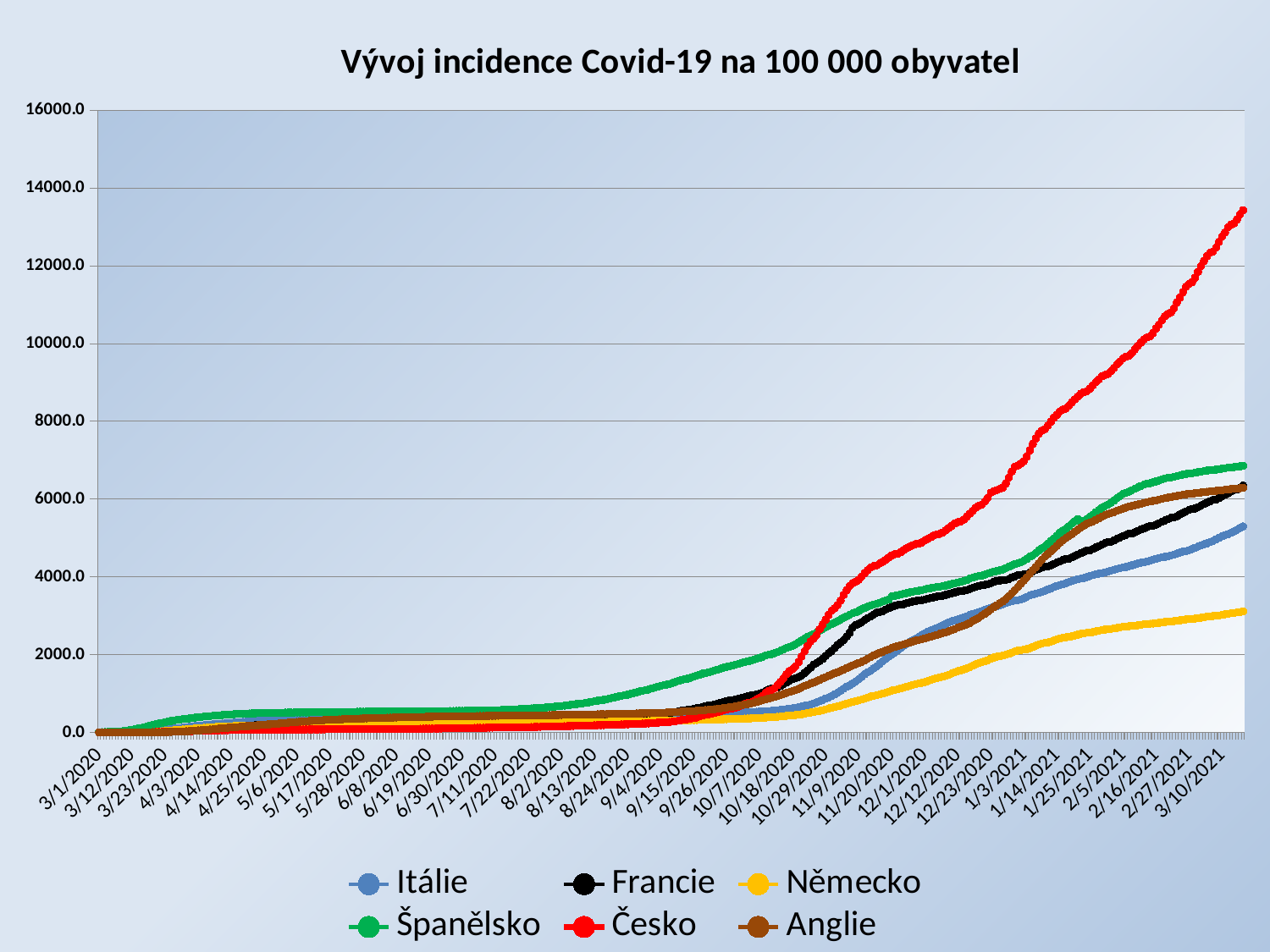
Which country has the highest incidence at the end of the period (3/10/2021)? Česko What is the title of the chart? Vývoj incidence Covid-19 na 100 000 obyvatel Is the value for Česko at 3/10/2021 greater or less than 12000? greater How many series does the legend list? 6 Do the values for Česko rise or fall over the period shown? rise At 3/10/2021, which is larger: the value for Španělsko or the value for Itálie? Španělsko At 3/10/2021, which is larger: the value for Česko or the value for Německo? Česko Is the value for Německo at 3/10/2021 greater or less than 4000? less Is the value for Itálie at 3/10/2021 greater or less than 6000? less Which country has the lowest incidence at the end of the period (3/10/2021)? Německo What kind of chart is shown on the slide? line chart